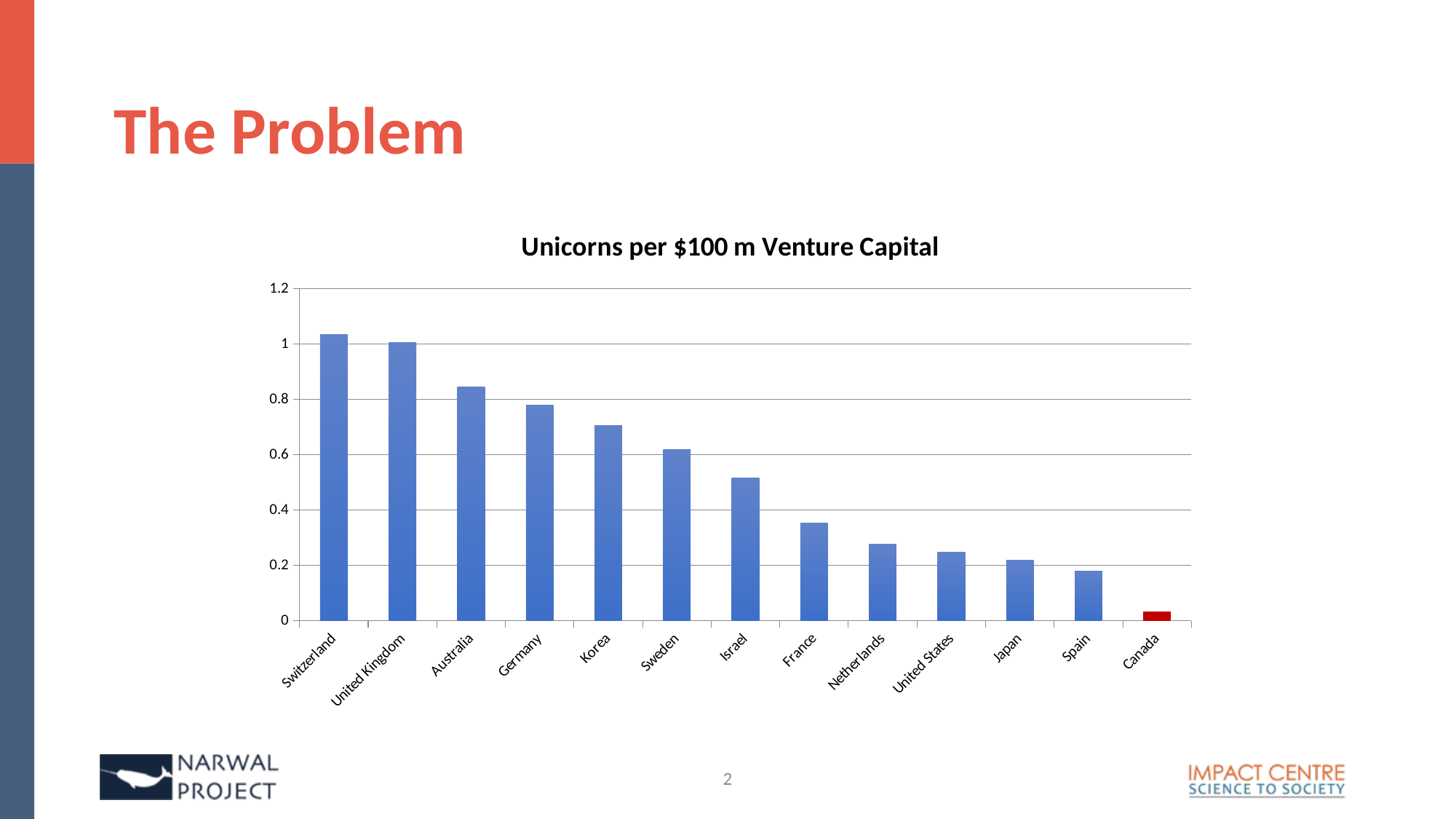
Is the value for France greater or less than 0.4? less Do the values rise or fall moving from left to right along the x axis? fall Is the value for Israel greater or less than 0.4? greater Which country's bar is coloured red instead of blue? Canada Is the value for Spain greater or less than 0.2? less Which country has the lowest value on the chart? Canada How many countries are shown on the chart? 13 What type of chart is shown on the slide? bar chart What is the title of the chart? Unicorns per $100 m Venture Capital Which has a higher value, Germany or Korea? Germany